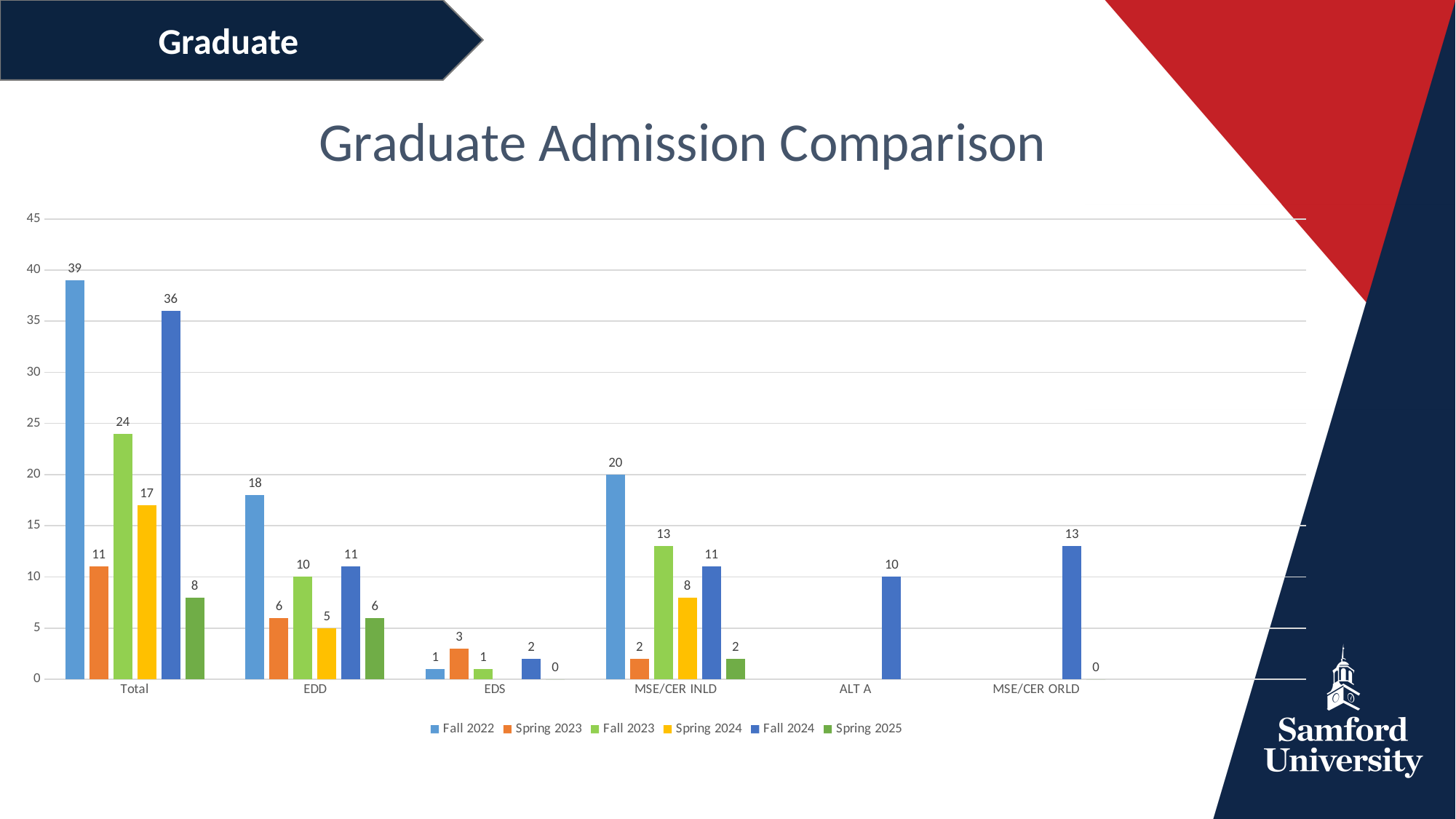
Which is larger for MSE/CER INLD: Fall 2023 or Fall 2024? Fall 2023 What is the Fall 2024 value for MSE/CER ORLD? 13 What is the Spring 2024 value for MSE/CER INLD? 8 What is the Fall 2022 value for Total? 39 What is the difference between the Fall 2022 and Fall 2024 values for Total? 3 What is the title of the chart? Graduate Admission Comparison What is the Fall 2024 value for ALT A? 10 Which series has the lowest value for Total? Spring 2025 What kind of chart is shown? Bar chart How many categories are shown on the x axis? 6 Which series has the highest value for EDD? Fall 2022 How many series does the legend list? 6